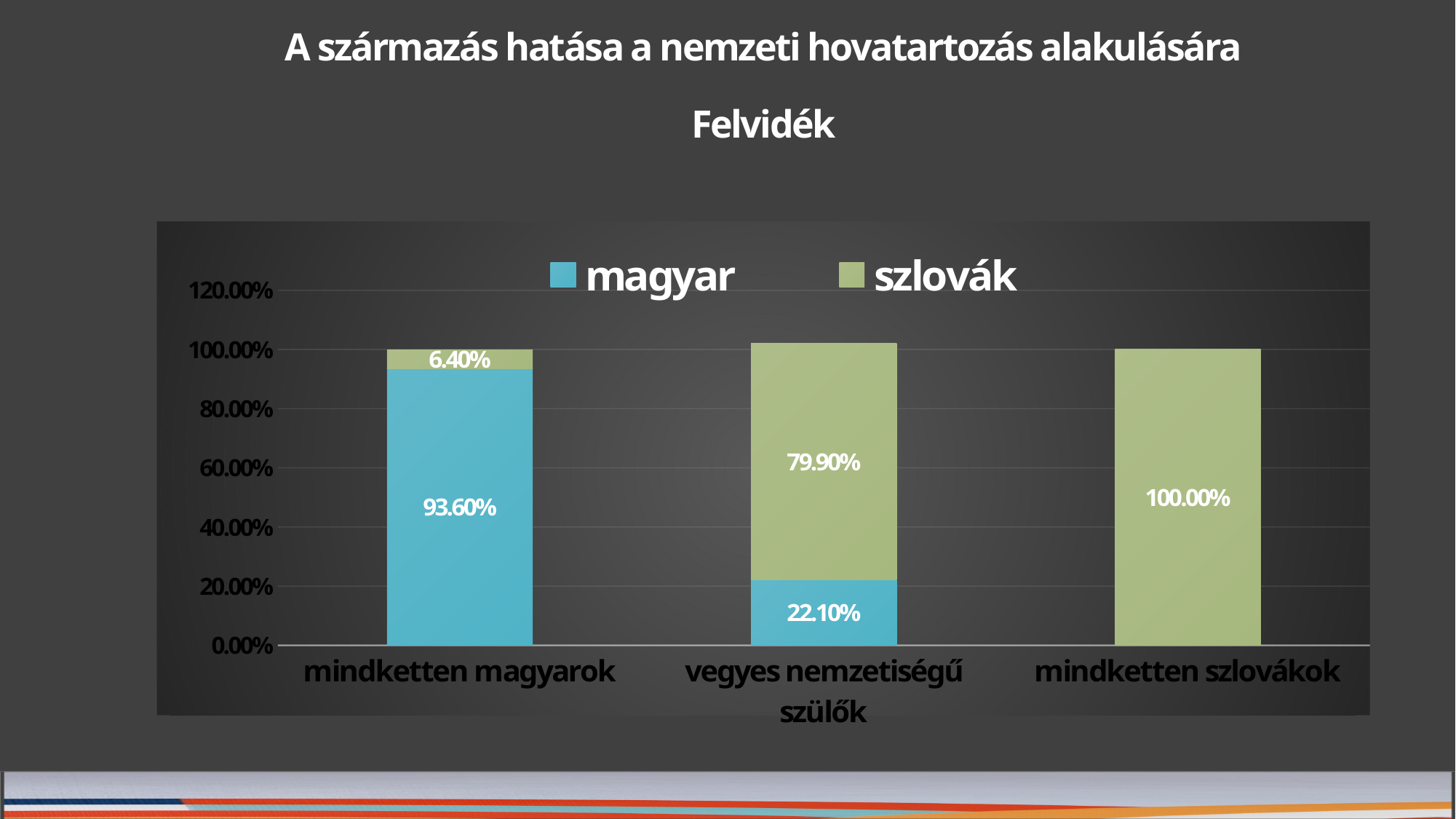
What is the value of the magyar series for 'vegyes nemzetiségű szülők'? 22.10% What is the value of the magyar series for the category 'mindketten magyarok'? 93.60% What is the value of the szlovák series for 'vegyes nemzetiségű szülők'? 79.90% How many categories are shown on the x axis? 3 How many series does the legend list? 2 What is the value of the szlovák series for the category 'mindketten magyarok'? 6.40% What is the difference between the magyar and szlovák values for 'vegyes nemzetiségű szülők'? 57.80% Which category has the lowest value for the magyar series among those with a magyar label? vegyes nemzetiségű szülők What is the value of the szlovák series for 'mindketten szlovákok'? 100.00% For 'mindketten magyarok', which series has the larger value, magyar or szlovák? magyar Which category has the highest value for the szlovák series? mindketten szlovákok What type of chart is shown on the slide? stacked bar chart